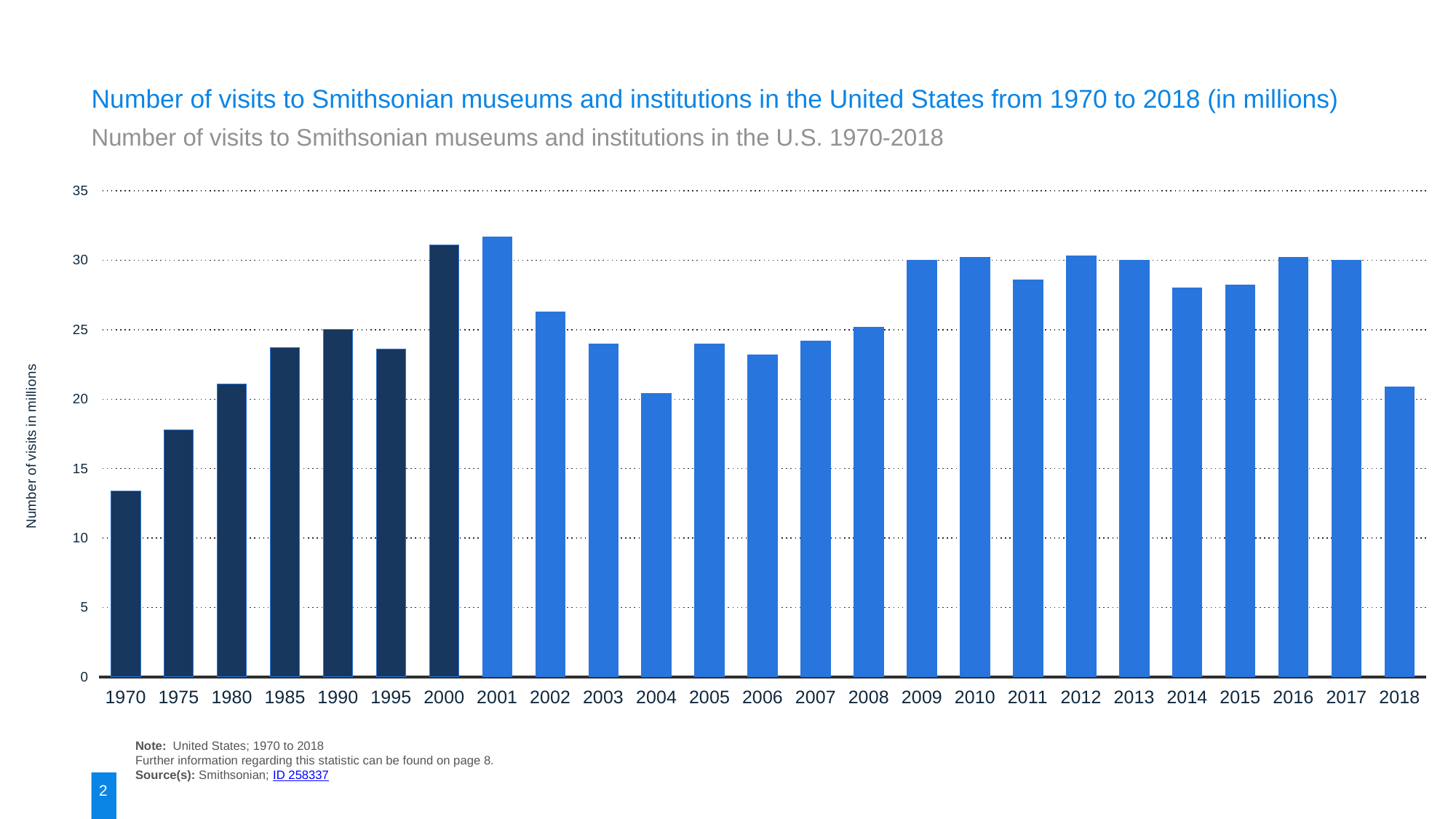
Is the value for 1970 greater or less than 15? less How many years are shown on the x axis of the chart? 25 Is the value for 2002 greater or less than 25? greater Which year has the highest number of visits? 2001 Is the value for 2001 greater or less than 30? greater Which year has more visits, 2000 or 2004? 2000 Which year has the lowest number of visits? 1970 Which year has more visits, 1980 or 1985? 1985 What kind of chart is shown on the slide? bar chart What is the label of the y axis? Number of visits in millions Do the values rise or fall from 1970 to 1990? rise